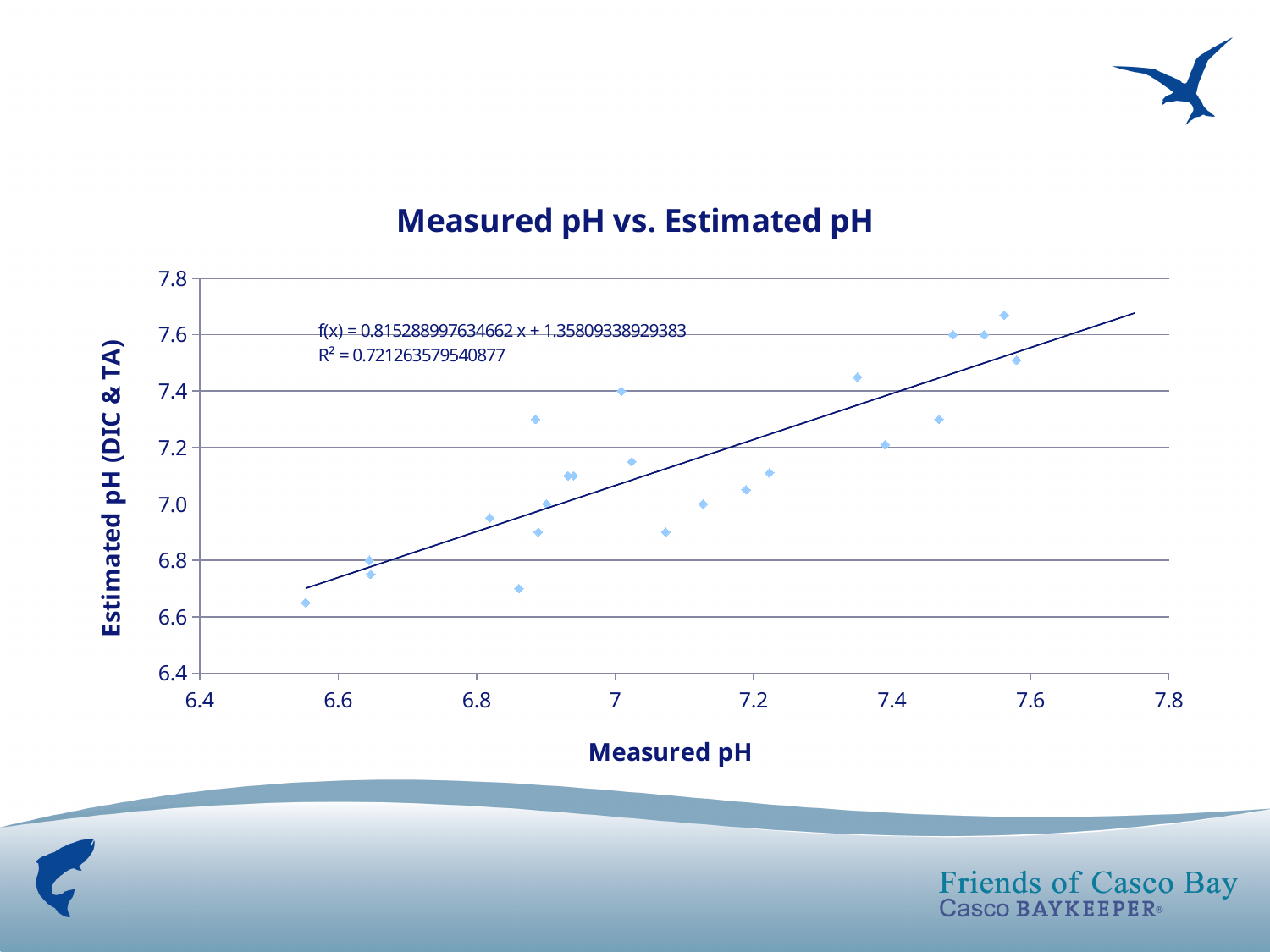
What is the intercept in the trendline equation printed on the chart? 1.35809338929383 What is the label of the vertical axis? Estimated pH (DIC & TA) Is the highest plotted estimated pH value greater or less than 7.6? greater What R² value is printed on the chart? 0.721263579540877 Is the largest measured pH value plotted greater or less than 7.6? less What is the maximum value shown on the horizontal (Measured pH) axis? 7.8 What is the slope (coefficient of x) in the trendline equation printed on the chart? 0.815288997634662 Is the smallest measured pH value plotted greater or less than 6.6? less What kind of chart is shown on the slide? scatter chart Do the estimated pH values generally rise or fall as measured pH increases along the x axis? rise What is the title of the chart? Measured pH vs. Estimated pH